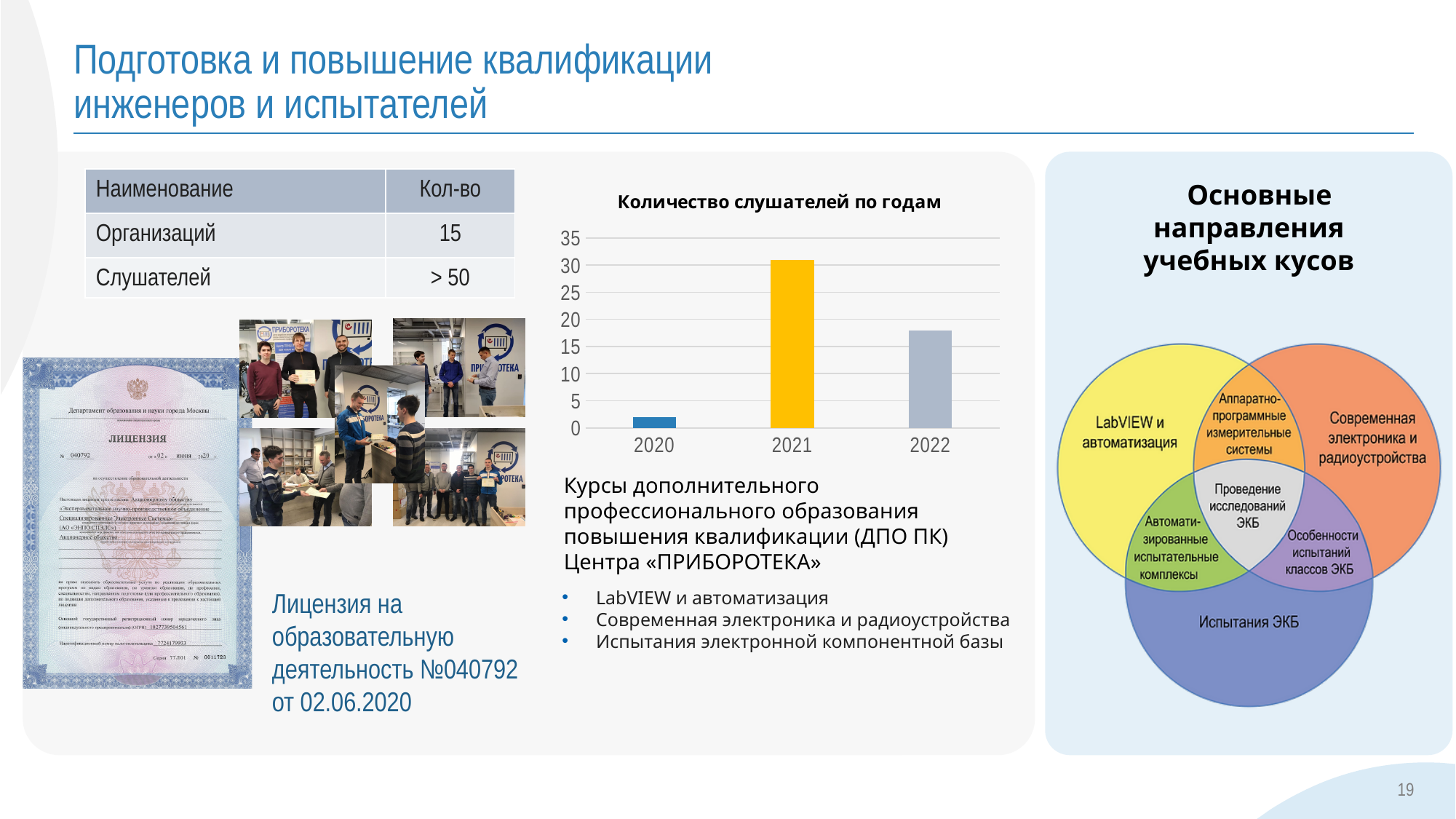
Which year has the larger value in the chart, 2020 or 2022? 2022 How many years are shown on the x axis of the chart? 3 Is the value for 2021 greater or less than 25? greater What kind of chart is shown under the title "Количество слушателей по годам"? bar chart Which year has the lowest number of listeners in the chart? 2020 Is the value for 2022 greater or less than 20? less Is the value for 2022 greater or less than 15? greater What is the title of the chart on the slide? Количество слушателей по годам Which year has the larger value in the chart, 2021 or 2022? 2021 Which year has the highest number of listeners in the chart? 2021 What colour is the bar for 2021 in the chart? yellow